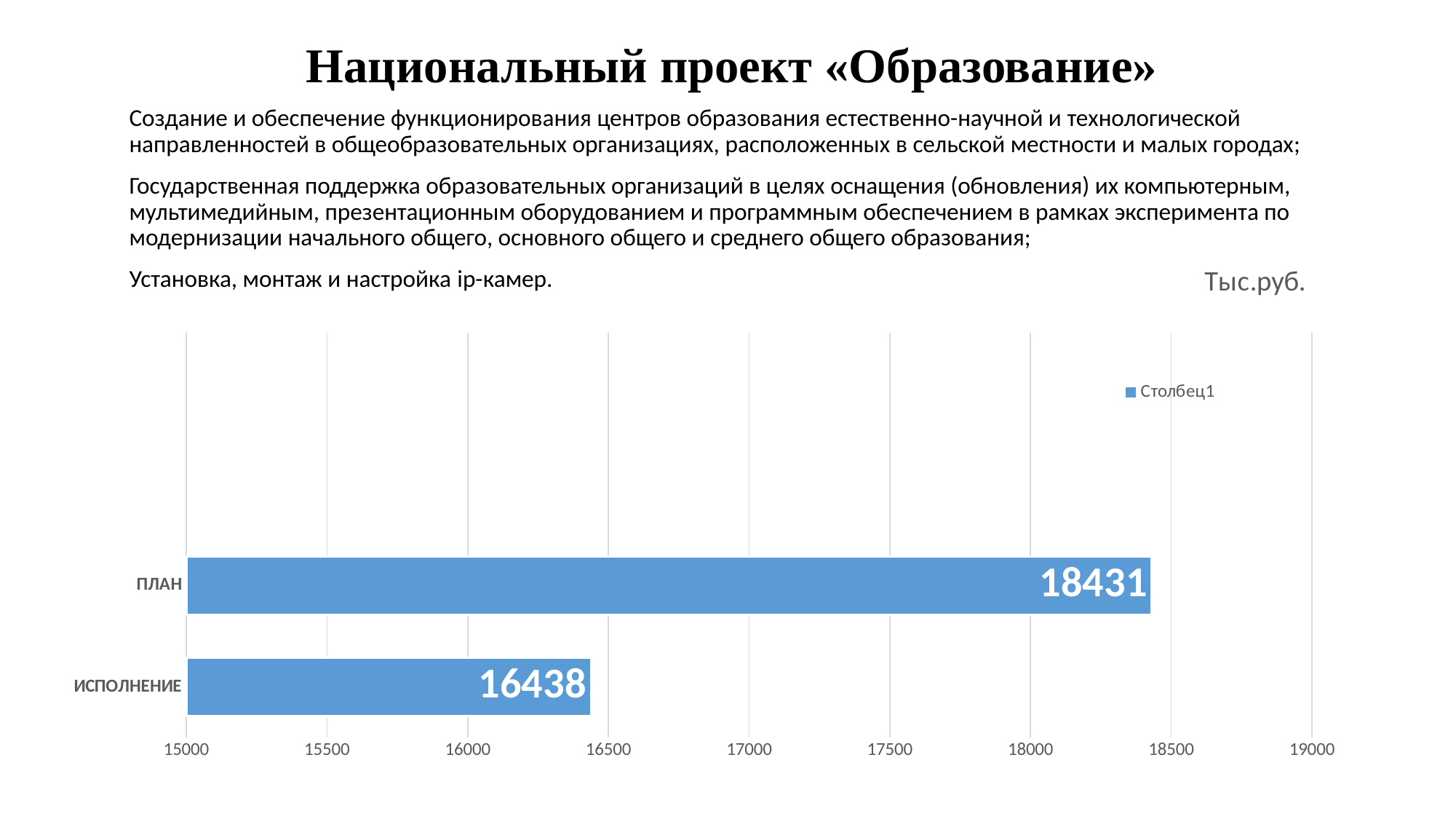
Which is larger, ПЛАН or ИСПОЛНЕНИЕ? ПЛАН Is the value for ИСПОЛНЕНИЕ greater or less than 16500? less What is the difference between the ПЛАН and ИСПОЛНЕНИЕ values? 1993 What is the value for ПЛАН? 18431 Is the value for ПЛАН greater or less than 18000? greater How many series does the legend list? 1 Which category has the highest value? ПЛАН Which category has the lowest value? ИСПОЛНЕНИЕ What unit is indicated above the chart? Тыс.руб. What kind of chart is shown on the slide? bar chart What is the value for ИСПОЛНЕНИЕ? 16438 How many categories are shown in the chart? 2